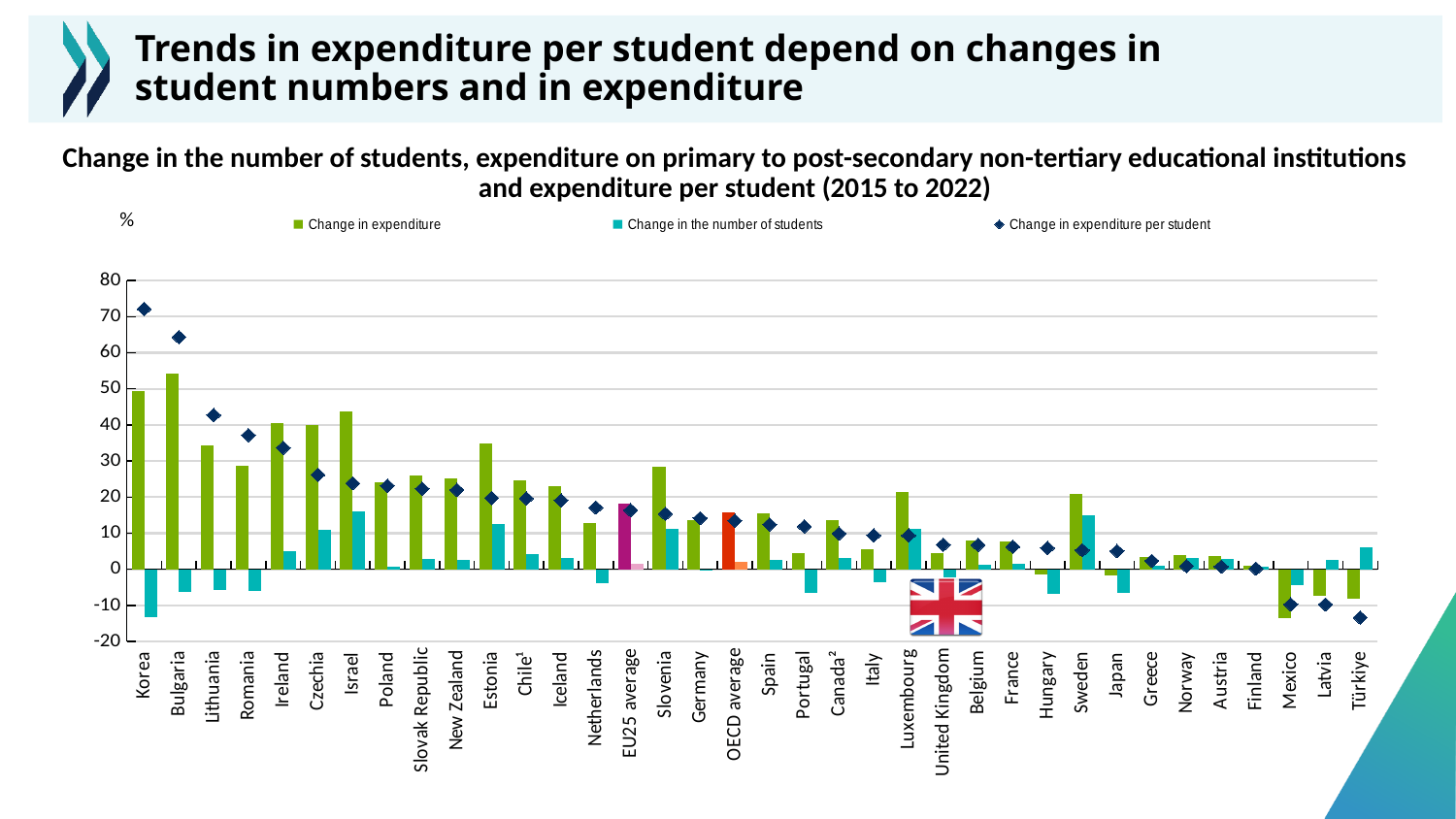
Which series is shown with dark blue diamond markers? Change in expenditure per student How many series does the legend list? 3 Which is larger, the change in expenditure for Korea or for Bulgaria? Bulgaria Is the change in expenditure per student for Korea greater or less than 60? greater What kind of chart is shown on the slide? Bar chart with diamond markers (combination chart) Is the change in the number of students for Sweden greater or less than 10? greater Which country has the lowest change in expenditure? Mexico Which country has the lowest change in the number of students? Korea Do the values for change in expenditure per student rise or fall from left to right along the x axis? fall Which country has the highest change in expenditure per student? Korea Which country has the highest change in expenditure? Bulgaria How many countries or averages are shown along the x axis? 36